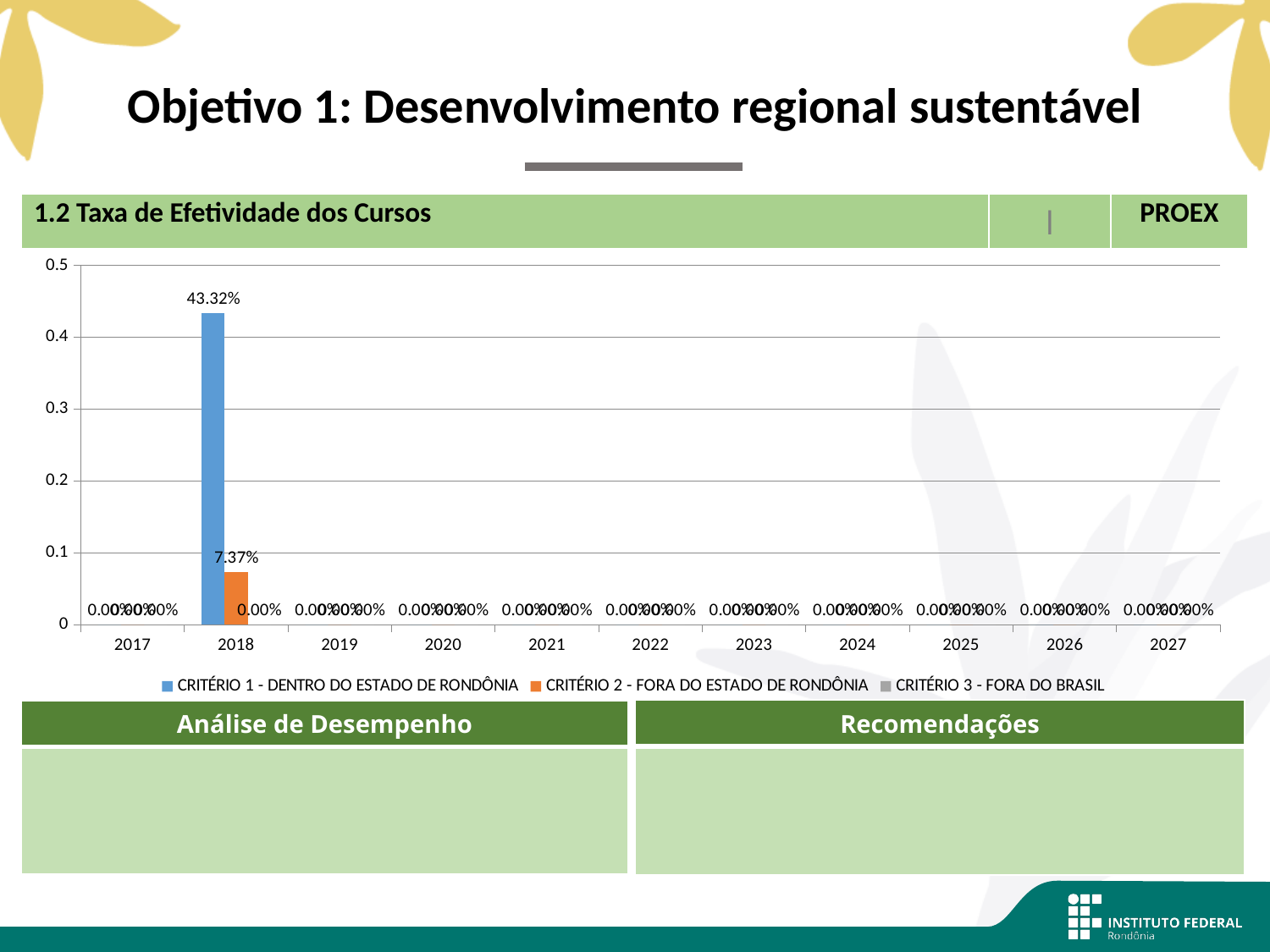
What is the difference between the CRITÉRIO 1 and CRITÉRIO 2 values in 2018? 35.95% What kind of chart is shown on the slide? bar chart How many years are shown on the x axis of the chart? 11 What is the value for CRITÉRIO 1 - DENTRO DO ESTADO DE RONDÔNIA in 2018? 43.32% In 2018, which is larger: CRITÉRIO 1 - DENTRO DO ESTADO DE RONDÔNIA or CRITÉRIO 2 - FORA DO ESTADO DE RONDÔNIA? CRITÉRIO 1 - DENTRO DO ESTADO DE RONDÔNIA What is the value for CRITÉRIO 2 - FORA DO ESTADO DE RONDÔNIA in 2018? 7.37% Is the value for CRITÉRIO 2 - FORA DO ESTADO DE RONDÔNIA in 2018 greater or less than 0.1? less What is the value for CRITÉRIO 3 - FORA DO BRASIL in 2018? 0.00% Is the value for CRITÉRIO 1 - DENTRO DO ESTADO DE RONDÔNIA in 2018 greater or less than 0.4? greater How many series does the chart legend list? 3 What is the title of the chart section on the slide? 1.2 Taxa de Efetividade dos Cursos Which year has the highest value for CRITÉRIO 1 - DENTRO DO ESTADO DE RONDÔNIA? 2018